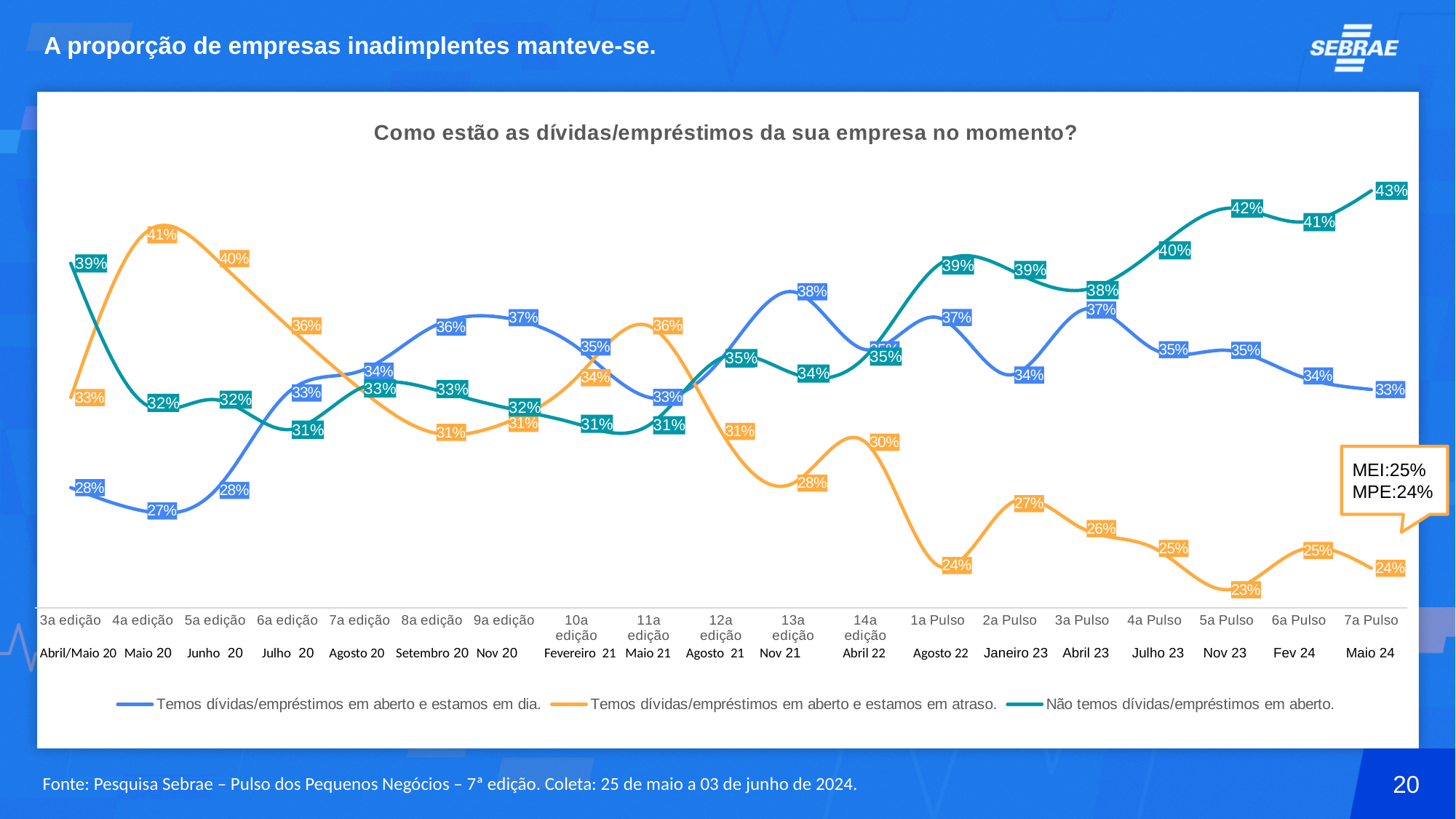
How many series does the legend list? 3 What is the value of 'Não temos dívidas/empréstimos em aberto.' at 7a Pulso (Maio 24)? 43% What is the value of 'Temos dívidas/empréstimos em aberto e estamos em dia.' at 13a edição (Nov 21)? 38% How many survey editions (categories) are plotted along the x axis? 19 In which edition does 'Temos dívidas/empréstimos em aberto e estamos em atraso.' reach its lowest value? 5a Pulso (Nov 23) What values does the callout box on the right of the chart show for MEI and MPE? MEI: 25%, MPE: 24% What kind of chart is shown on the slide? Line chart At 7a Pulso (Maio 24), what is the difference between 'Não temos dívidas/empréstimos em aberto.' and 'Temos dívidas/empréstimos em aberto e estamos em atraso.'? 19 percentage points At 3a edição (Abril/Maio 20), which is larger: 'Não temos dívidas/empréstimos em aberto.' or 'Temos dívidas/empréstimos em aberto e estamos em dia.'? Não temos dívidas/empréstimos em aberto. In which edition does 'Não temos dívidas/empréstimos em aberto.' reach its highest value? 7a Pulso (Maio 24) From 3a Pulso (Abril 23) to 7a Pulso (Maio 24), does 'Temos dívidas/empréstimos em aberto e estamos em dia.' rise or fall? Fall What is the value of 'Temos dívidas/empréstimos em aberto e estamos em atraso.' at 4a edição (Maio 20)? 41%